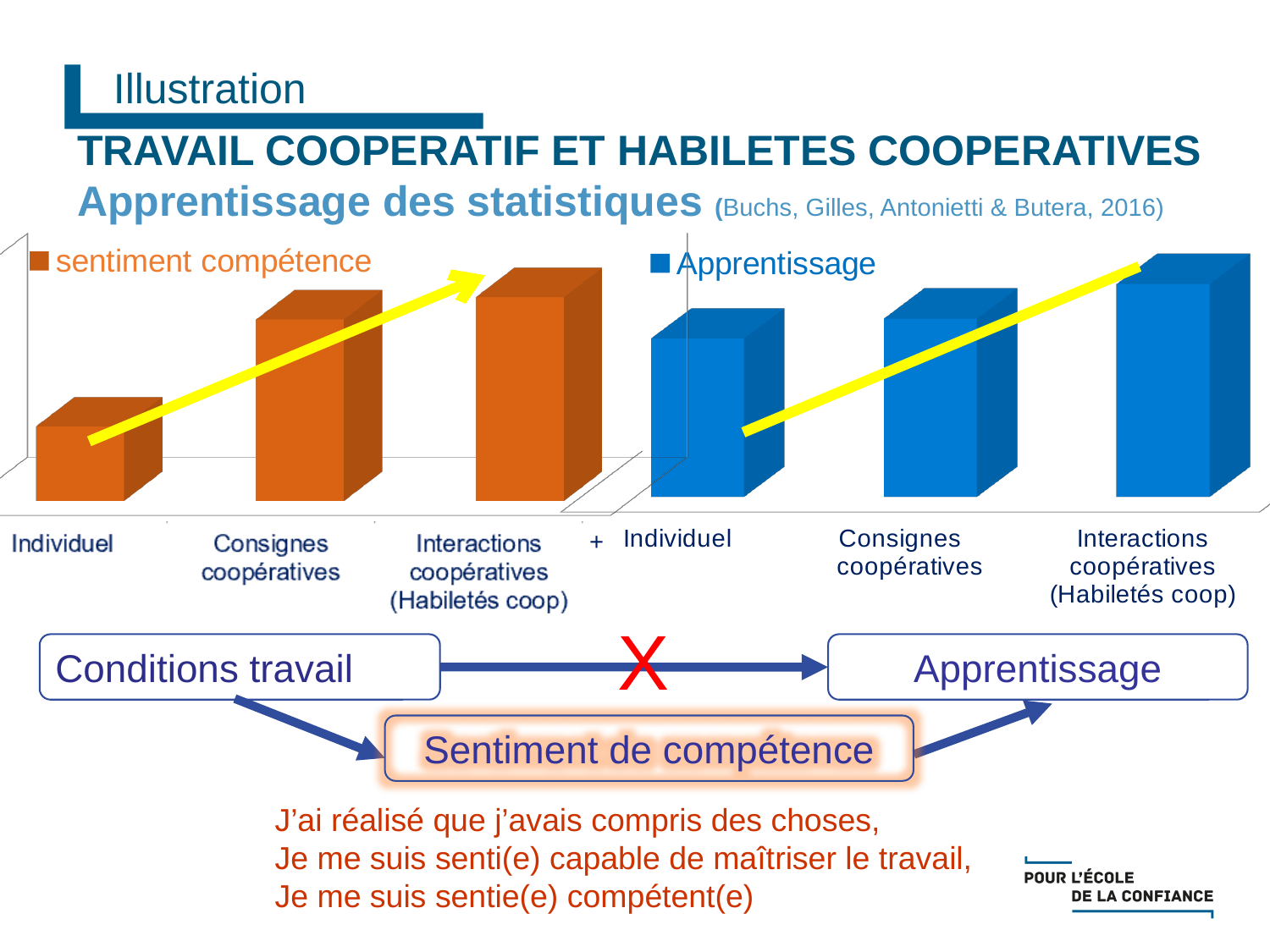
In the left chart (sentiment compétence), which category has the lowest bar? Individuel What colour are the bars in the right chart labelled "Apprentissage"? blue In the left chart (sentiment compétence), which is larger: the bar for Individuel or the bar for Consignes coopératives? Consignes coopératives In the right chart (Apprentissage), how many bars are plotted? 3 What kind of chart is the left chart labelled "sentiment compétence"? bar chart In the left chart (sentiment compétence), how many categories are shown on the x axis? 3 In the right chart (Apprentissage), do the bars rise or fall from Individuel to Interactions coopératives? rise How many series does the legend of the left chart list? 1 In the right chart (Apprentissage), which category has the highest bar? Interactions coopératives (Habiletés coop) In the right chart (Apprentissage), which category has the lowest bar? Individuel What kind of chart is the right chart labelled "Apprentissage"? bar chart In the left chart (sentiment compétence), which category has the highest bar? Interactions coopératives (Habiletés coop)